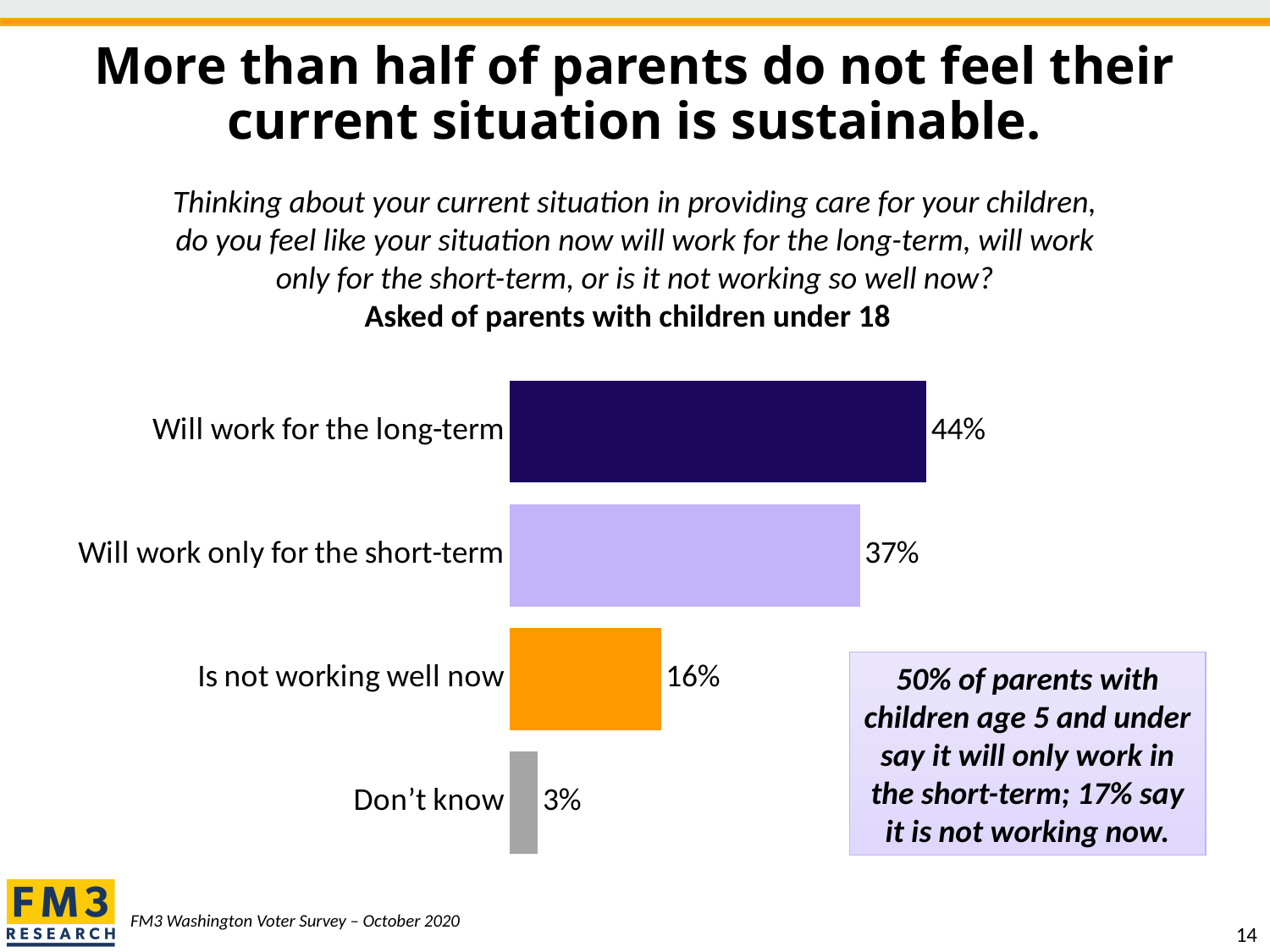
How many response categories are shown in the chart? 4 Which response has the highest percentage? Will work for the long-term Which is larger: the percentage for "Is not working well now" or for "Don't know"? Is not working well now What kind of chart is shown on the slide? Bar chart What is the difference in percentage points between "Will work only for the short-term" and "Is not working well now"? 21 What percentage of parents say their situation is not working well now? 16% What percentage of parents say their situation will work for the long-term? 44% What is the difference in percentage points between "Will work for the long-term" and "Will work only for the short-term"? 7 What percentage of parents say their situation will work only for the short-term? 37% What colour is the bar for "Is not working well now"? Orange Which response has the lowest percentage? Don't know What percentage of parents answered "Don't know"? 3%